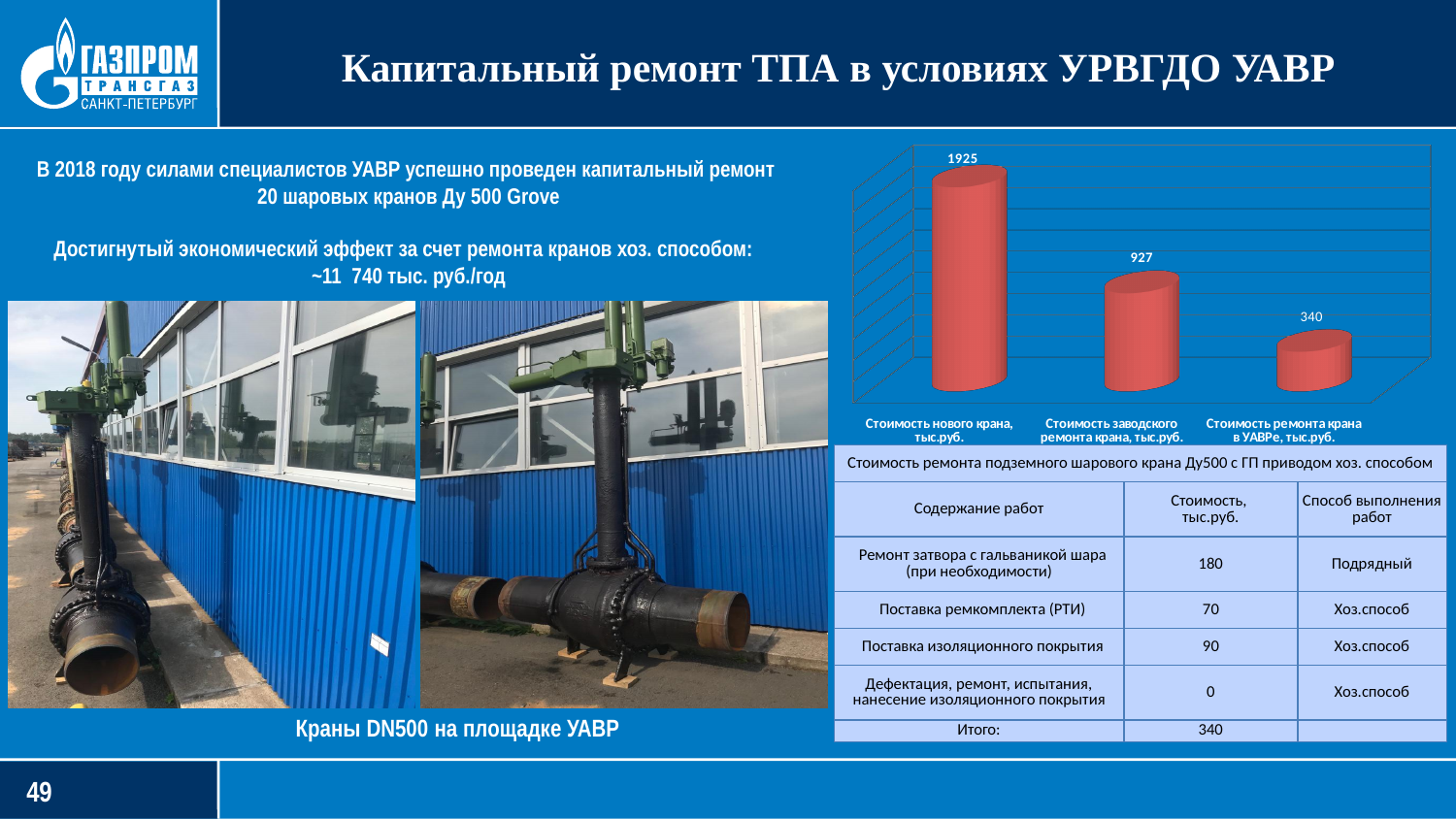
Which is larger: the value for "Стоимость заводского ремонта крана, тыс.руб." or the value for "Стоимость ремонта крана в УАВРе, тыс.руб."? Стоимость заводского ремонта крана, тыс.руб. How many categories are plotted in the chart? 3 Do the values in the chart rise or fall from left to right? Fall What is the value shown for "Стоимость заводского ремонта крана, тыс.руб." in the chart? 927 Which category has the lowest value in the chart? Стоимость ремонта крана в УАВРе, тыс.руб. What kind of chart is shown on the slide? Bar chart What is the difference between the value for "Стоимость нового крана, тыс.руб." and the value for "Стоимость заводского ремонта крана, тыс.руб."? 998 What is the difference between the value for "Стоимость заводского ремонта крана, тыс.руб." and the value for "Стоимость ремонта крана в УАВРе, тыс.руб."? 587 Which category has the highest value in the chart? Стоимость нового крана, тыс.руб. What colour are the bars in the chart? Red What is the value shown for "Стоимость нового крана, тыс.руб." in the chart? 1925 What is the value shown for "Стоимость ремонта крана в УАВРе, тыс.руб." in the chart? 340